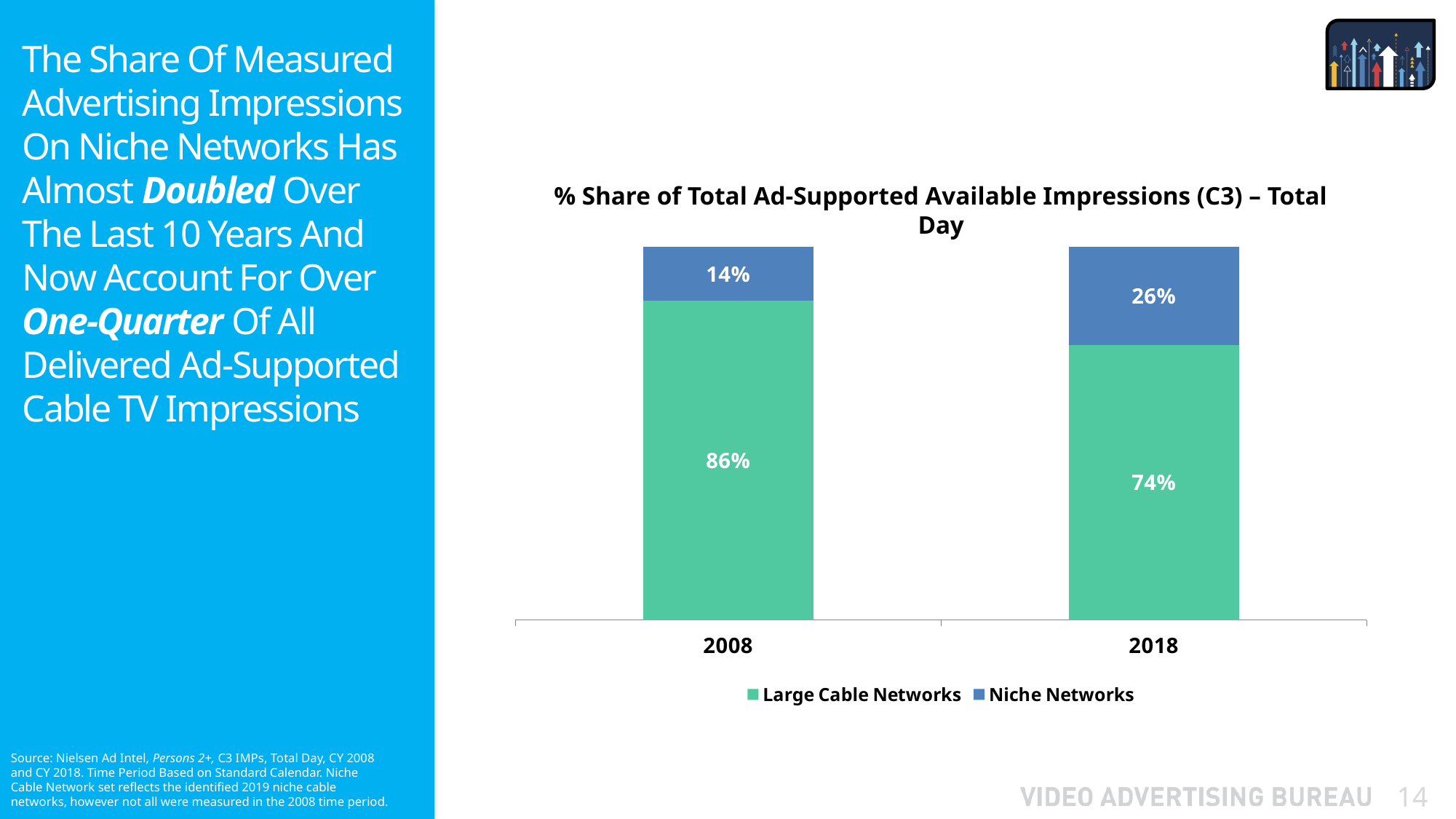
What is the difference between the Niche Networks share in 2018 and in 2008? 12% What is the value for Niche Networks in 2008? 14% How many series does the legend list? 2 What is the value for Large Cable Networks in 2018? 74% What is the value for Niche Networks in 2018? 26% Which is larger: Large Cable Networks in 2008 or Large Cable Networks in 2018? Large Cable Networks in 2008 What is the value for Large Cable Networks in 2008? 86% In which year is the Large Cable Networks share lower? 2018 What kind of chart is shown? Stacked bar chart In which year is the Niche Networks share higher? 2018 How many years are shown on the x axis? 2 Does the Niche Networks share rise or fall from 2008 to 2018? Rise